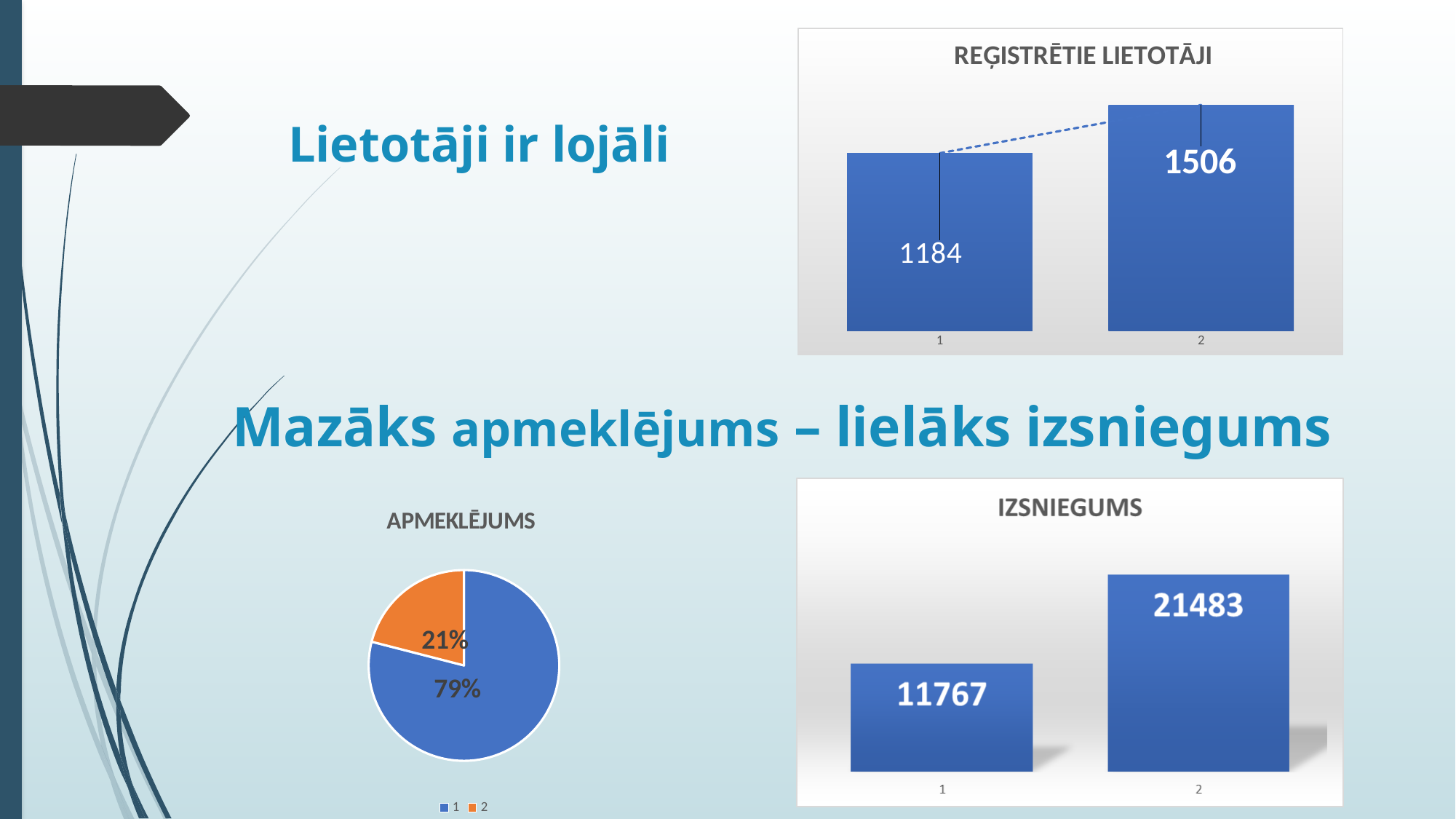
In the IZSNIEGUMS chart, what is the difference between the values for category 2 and category 1? 9716 In the REĢISTRĒTIE LIETOTĀJI chart, which category has the higher value? 2 In the APMEKLĒJUMS pie chart, what share does slice 1 have? 79% In the REĢISTRĒTIE LIETOTĀJI chart, what is the value for category 2? 1506 In the IZSNIEGUMS chart, what is the value for category 2? 21483 In the IZSNIEGUMS chart, what is the value for category 1? 11767 In the IZSNIEGUMS chart, do the values rise or fall from category 1 to category 2? rise In the APMEKLĒJUMS pie chart, what share does slice 2 have? 21% In the REĢISTRĒTIE LIETOTĀJI chart, what is the difference between the values for category 2 and category 1? 322 How many slices does the APMEKLĒJUMS pie chart have? 2 In the REĢISTRĒTIE LIETOTĀJI chart, what is the value for category 1? 1184 What kind of chart is the REĢISTRĒTIE LIETOTĀJI chart? bar chart